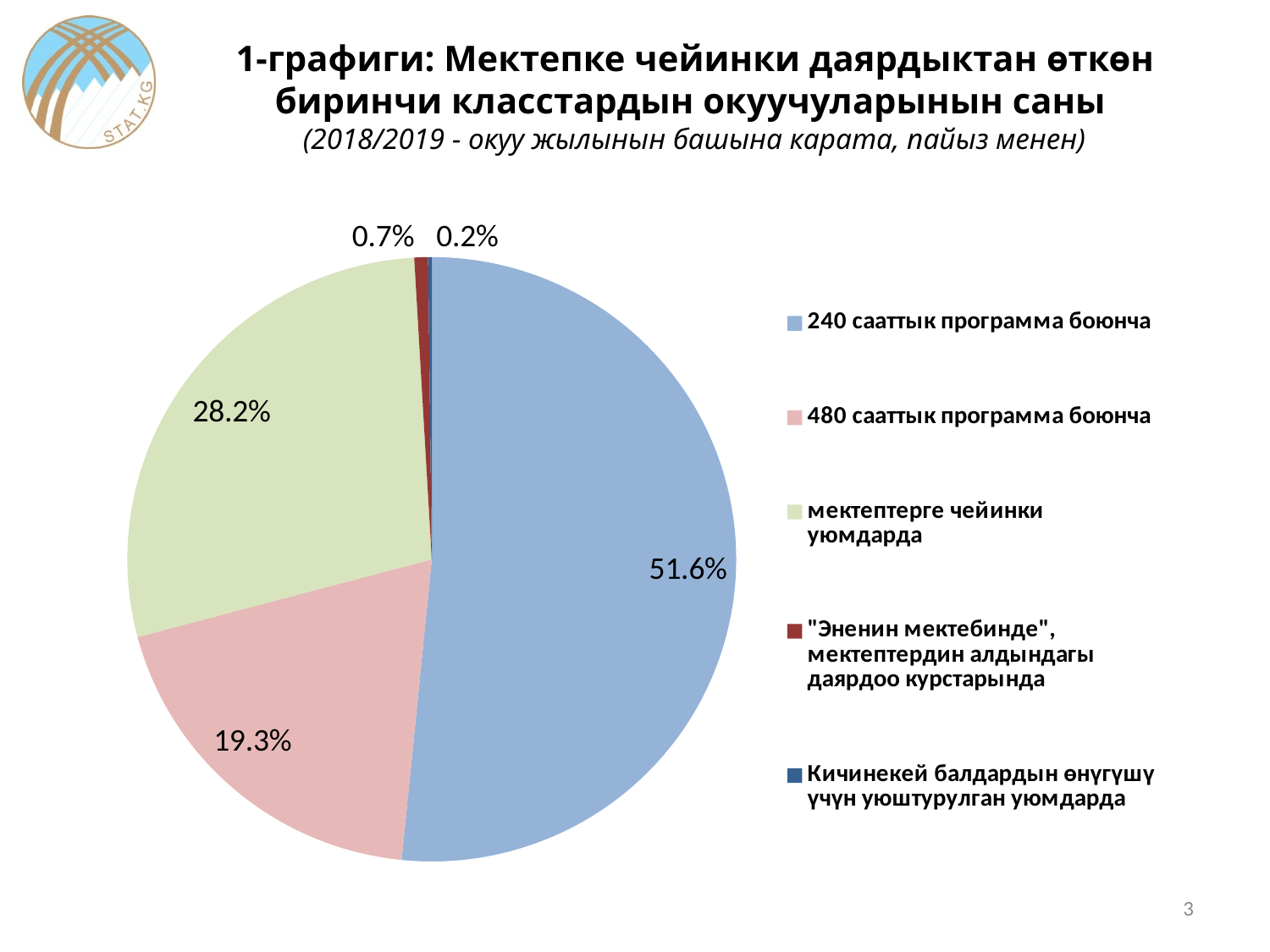
Which category has the largest slice of the pie? 240 сааттык программа боюнча What share of the pie does "240 сааттык программа боюнча" have? 51.6% What colour is the slice for "240 сааттык программа боюнча"? blue What share of the pie does ""Эненин мектебинде", мектептердин алдындагы даярдоо курстарында" have? 0.7% How many slices does the pie chart have? 5 Which is larger: the share for "480 сааттык программа боюнча" or the share for "мектептерге чейинки уюмдарда"? мектептерге чейинки уюмдарда What is the difference between the shares of "240 сааттык программа боюнча" and "мектептерге чейинки уюмдарда"? 23.4% What share of the pie does "480 сааттык программа боюнча" have? 19.3% Which category has the smallest slice of the pie? Кичинекей балдардын өнүгүшү үчүн уюштурулган уюмдарда What kind of chart is shown on the slide? pie chart What share of the pie does "Кичинекей балдардын өнүгүшү үчүн уюштурулган уюмдарда" have? 0.2% What share of the pie does "мектептерге чейинки уюмдарда" have? 28.2%